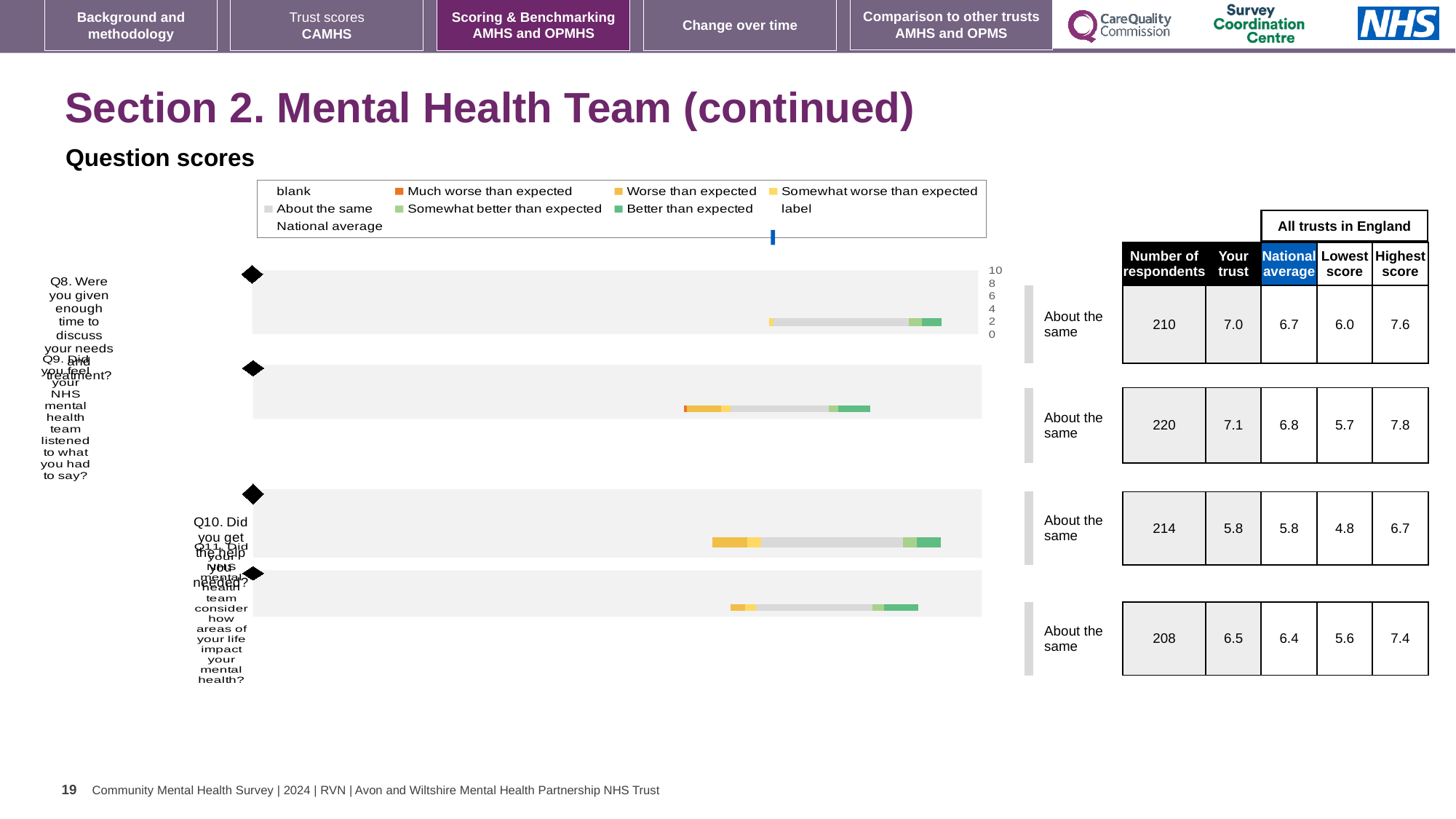
In the table beside the chart, what is the national average for Q11? 6.4 What is the heading above the chart on this slide? Question scores How many questions (categories) are plotted in the question scores chart? 4 In the table beside the chart, what is the 'Your trust' score for Q9? 7.1 What is the difference between the highest score and the lowest score for Q9 in the table beside the chart? 2.1 In the table beside the chart, what is the number of respondents for Q8? 210 Which question has the lowest 'Your trust' score in the table beside the chart? Q10 For Q8, which is larger in the table beside the chart: the 'Your trust' score or the national average? Your trust What is the highest value shown on the chart's numeric axis? 10 Which question has the highest number of respondents in the table beside the chart? Q9 In the table beside the chart, what is the lowest score across all trusts in England for Q10? 4.8 What kind of chart is used to show the question scores on this slide? bar chart